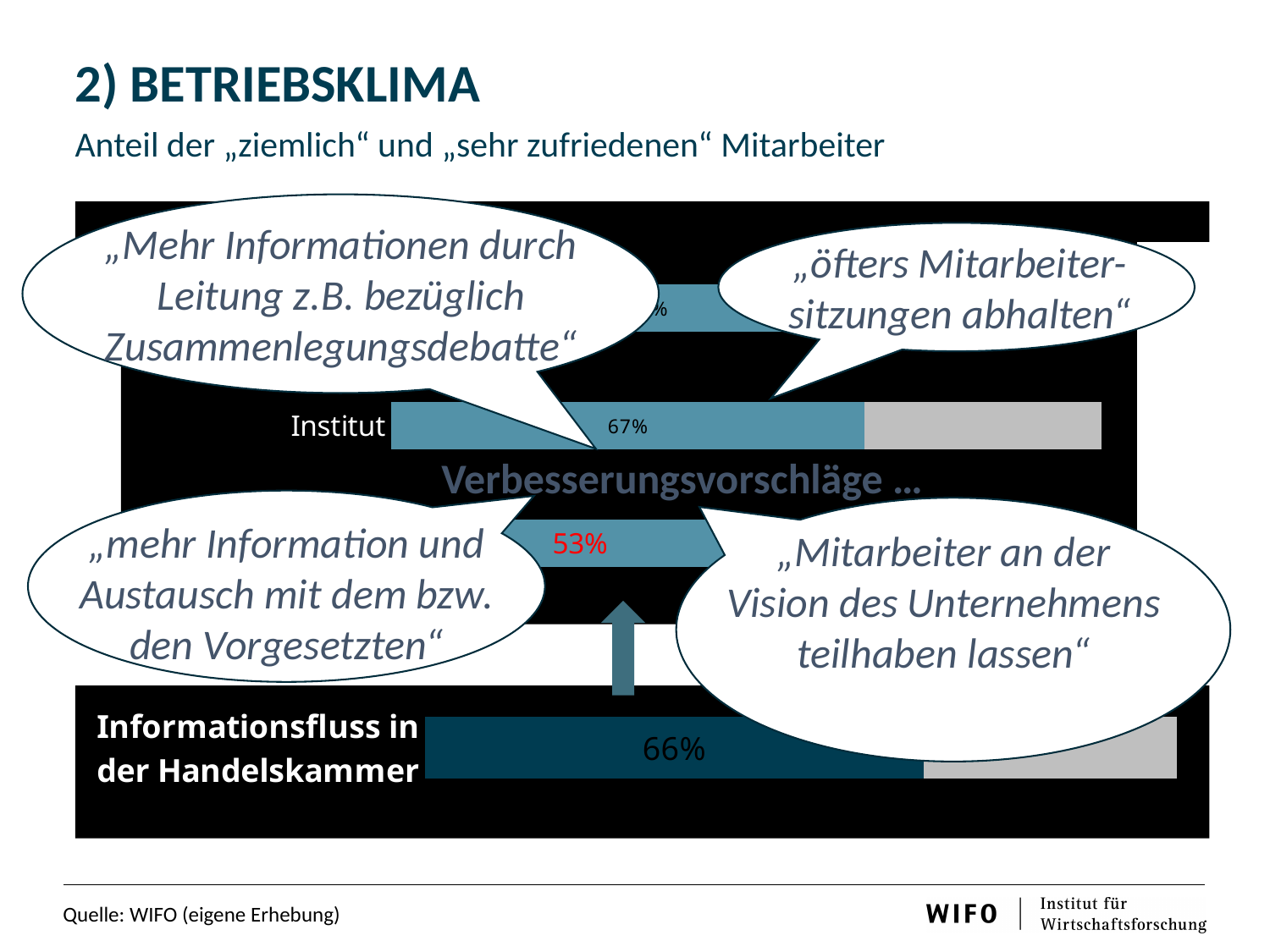
What is the value shown for Institut? 67% What kind of chart is shown on the slide? Bar chart What is the difference between the value for Institut and the value for Informationsfluss in der Handelskammer? 1 percentage point What is the title of the slide? 2) BETRIEBSKLIMA What is the value shown for Informationsfluss in der Handelskammer? 66% Which is larger, the value for Institut or the value for Informationsfluss in der Handelskammer? Institut What source is given for the data on the slide? WIFO (eigene Erhebung)